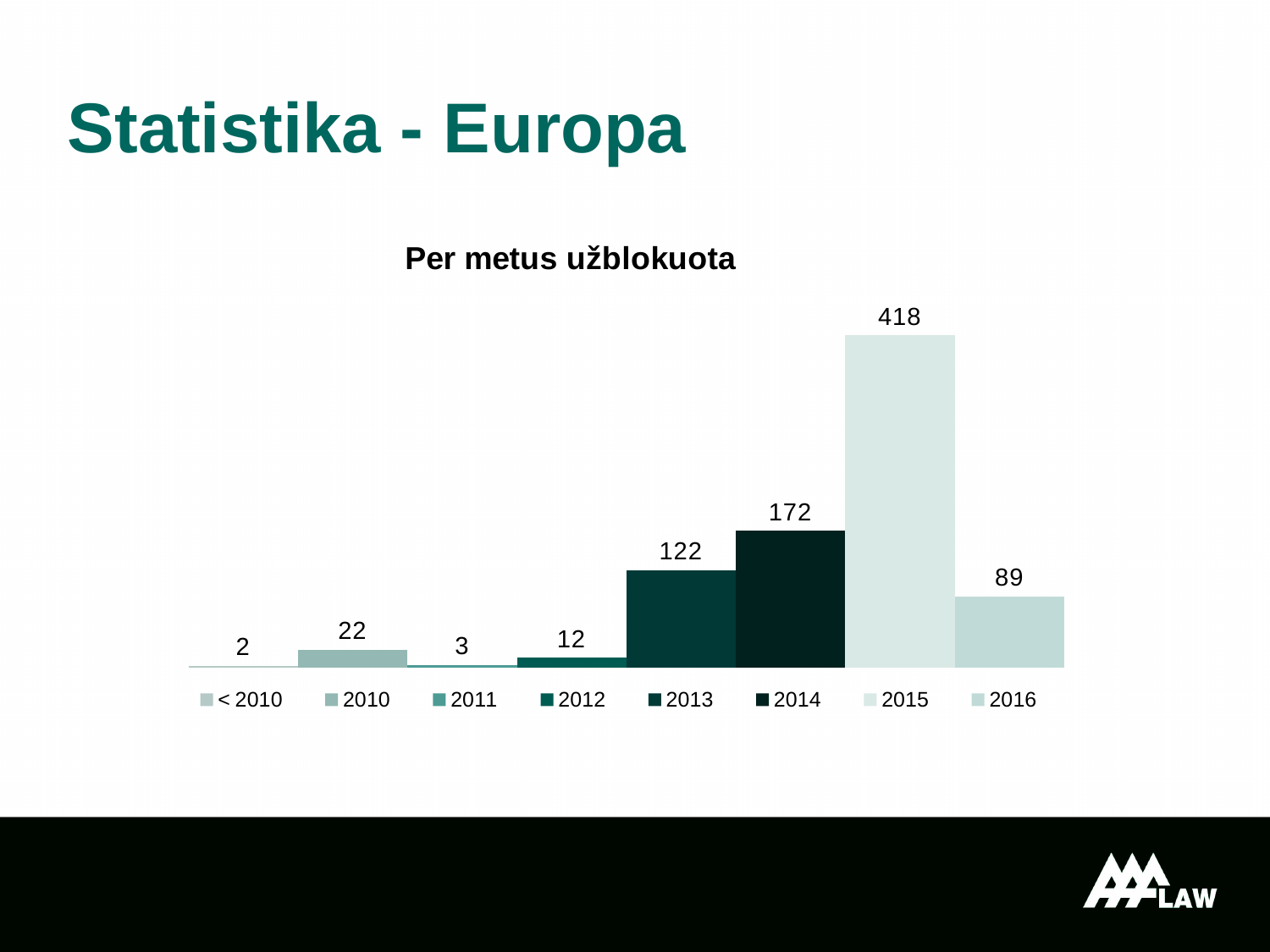
What is the value for 2016? 89 What is the value for 2013? 122 Which category has the lowest value? < 2010 Which is larger, the value for 2010 or the value for 2012? 2010 What is the difference between the values for 2014 and 2013? 50 What is the value for < 2010? 2 How many categories does the legend list? 8 What is the value for 2015? 418 What kind of chart is shown on the slide? bar chart Which category has the highest value? 2015 What is the difference between the values for 2015 and 2014? 246 What is the title of the chart? Per metus užblokuota